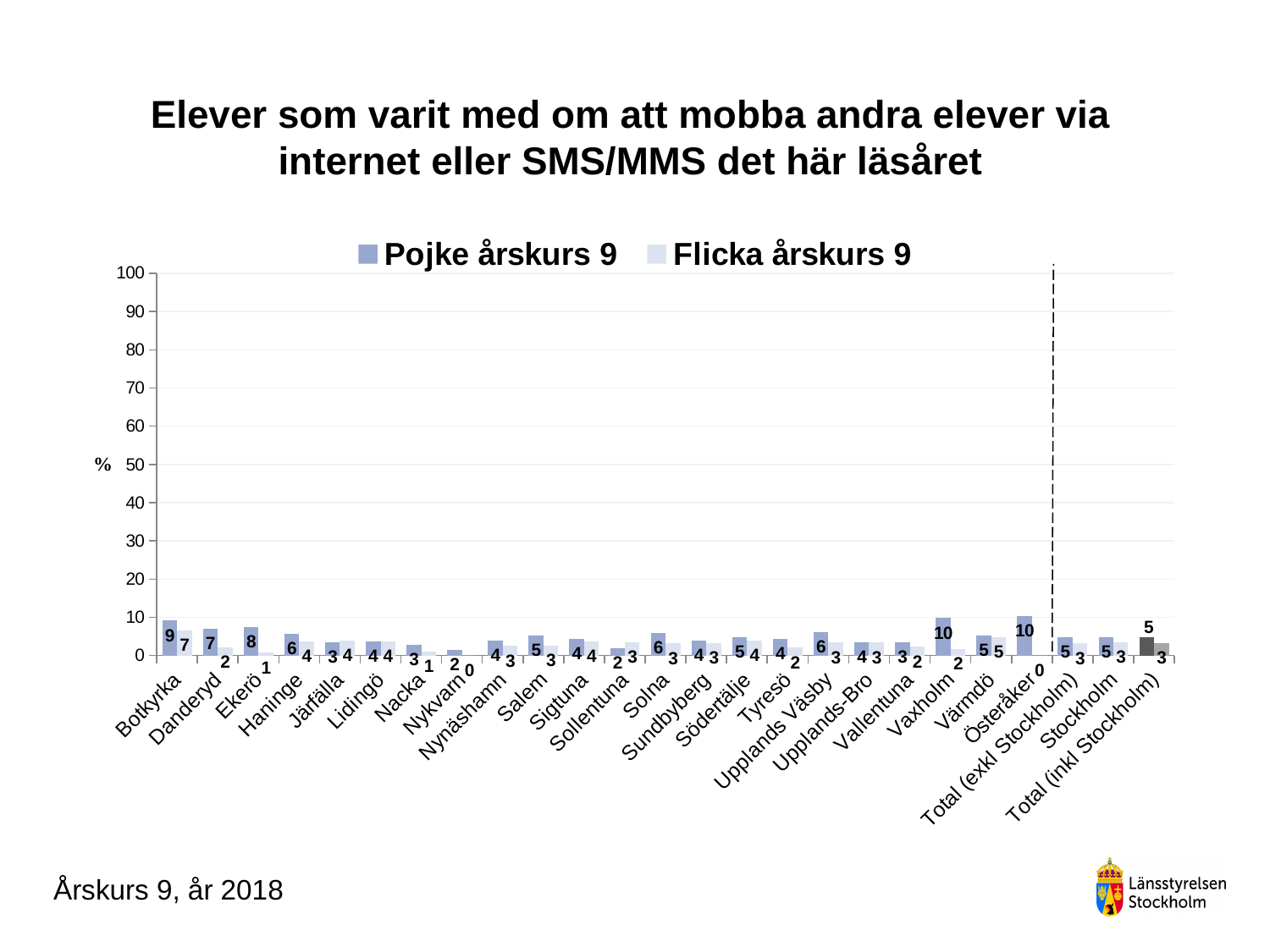
How many series does the legend list? 2 What is the value for Flicka årskurs 9 in Danderyd? 2 Is the value for Pojke årskurs 9 in Österåker greater or less than 50? less What is the difference between the Pojke årskurs 9 and Flicka årskurs 9 values in Danderyd? 5 What kind of chart is shown on the slide? bar chart What is the value for Pojke årskurs 9 in Vaxholm? 10 What is the value for Flicka årskurs 9 for Total (inkl Stockholm)? 3 What is the value for Pojke årskurs 9 in Botkyrka? 9 How many categories are shown on the x axis? 25 What is the difference between the Pojke årskurs 9 and Flicka årskurs 9 values in Ekerö? 7 In Haninge, which series has the larger value, Pojke årskurs 9 or Flicka årskurs 9? Pojke årskurs 9 Which category has the highest value for Flicka årskurs 9? Botkyrka